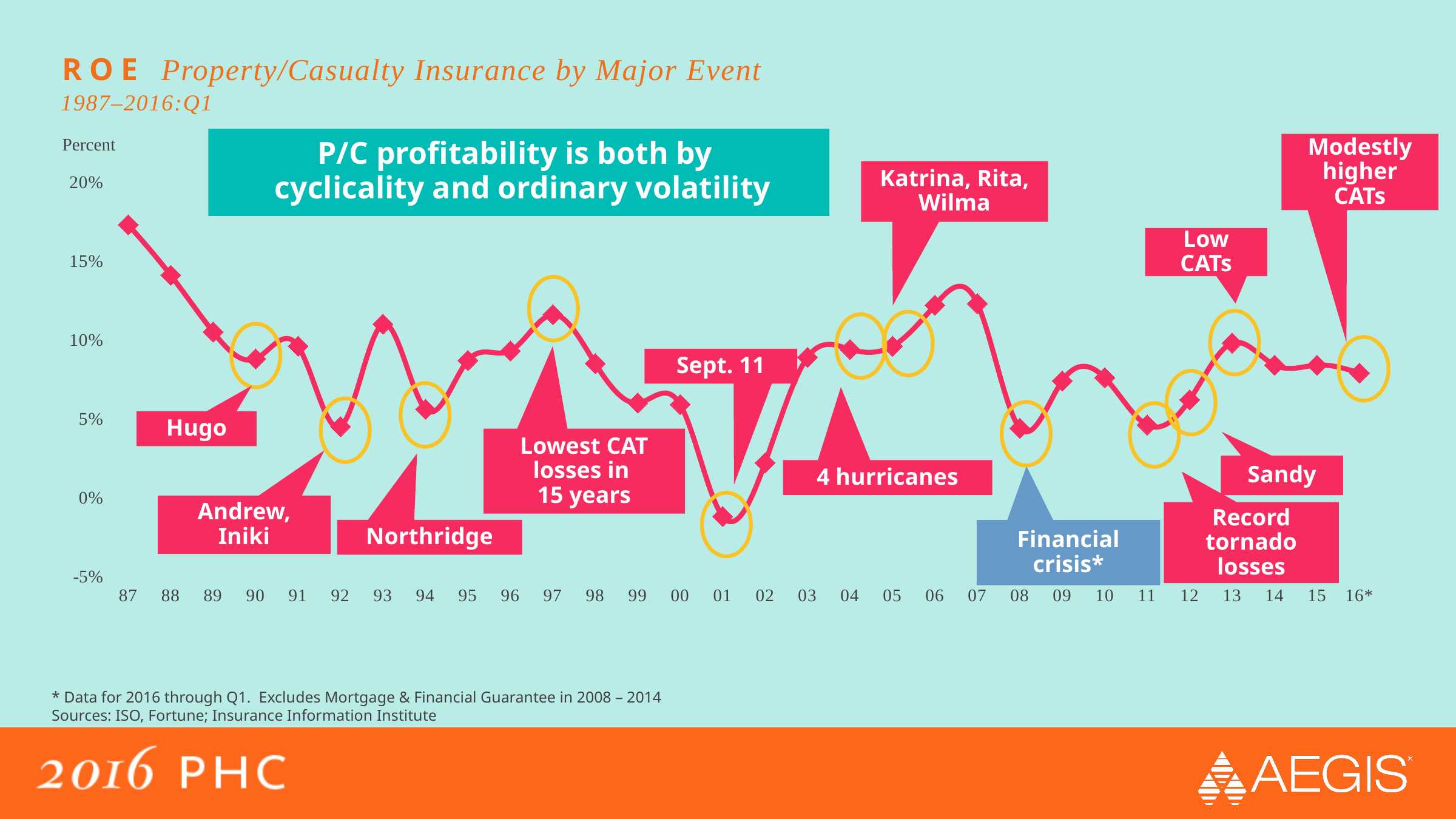
Which year has the highest ROE value on the chart? 87 Is the value for 01 greater or less than 0%? less How many years (data points) are plotted along the x axis? 30 Do the values rise or fall from 87 to 92? fall Which event is labelled at the low point in 01? Sept. 11 Which year has the larger ROE value, 06 or 08? 06 Which year has the lowest ROE value on the chart? 01 Is the value for 08 greater or less than 5%? less Is the value for 16* greater or less than 10%? less What kind of chart is shown on the slide? line chart